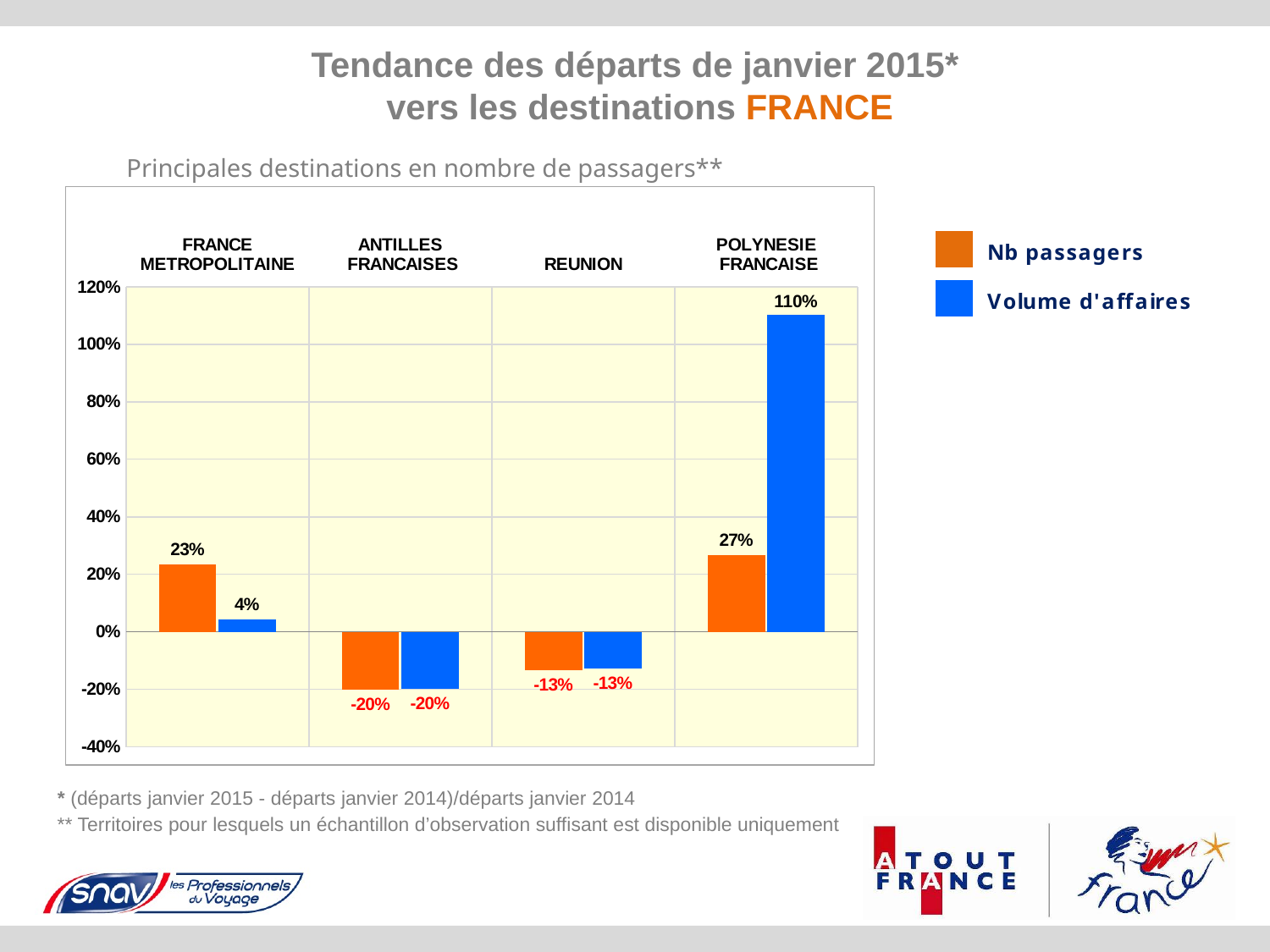
Which destination has the lowest Nb passagers value? ANTILLES FRANCAISES How many destinations are shown on the chart? 4 What is the Nb passagers value for FRANCE METROPOLITAINE? 23% What is the Volume d'affaires value for FRANCE METROPOLITAINE? 4% What is the difference between the Volume d'affaires and Nb passagers values for POLYNESIE FRANCAISE? 83% How many series does the legend list? 2 What kind of chart is shown on the slide? Bar chart Which destination has the highest Volume d'affaires value? POLYNESIE FRANCAISE Which is larger for FRANCE METROPOLITAINE: Nb passagers or Volume d'affaires? Nb passagers Is the Volume d'affaires value for POLYNESIE FRANCAISE greater or less than 100%? greater What is the Nb passagers value for REUNION? -13% What is the Volume d'affaires value for POLYNESIE FRANCAISE? 110%